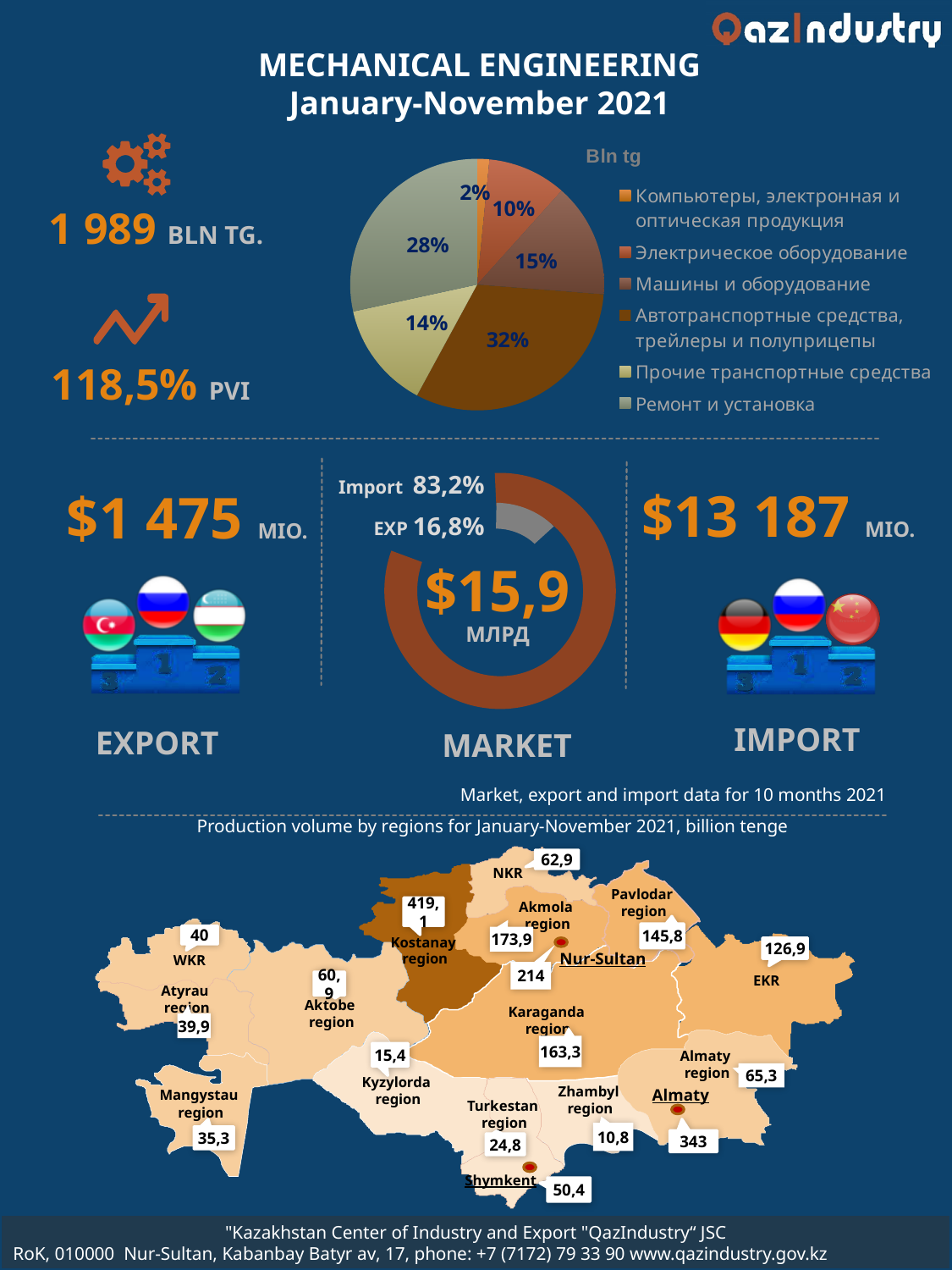
What kind of chart is the 'Bln tg' chart at the top of the slide? pie chart In the 'Bln tg' pie chart, what is the difference between the 32% slice and the 28% slice? 4% How many entries does the legend of the 'Bln tg' pie chart list? 6 In the MARKET donut chart, which is larger, Import or EXP? Import In the 'Bln tg' pie chart, what is the smallest slice's share? 2% In the MARKET donut chart, what share is EXP? 16,8% What value is shown in the centre of the MARKET donut chart? $15,9 млрд In the 'Bln tg' pie chart, what is the largest slice's share? 32% How many slices does the 'Bln tg' pie chart have? 6 On the regional production map, which region has the highest production volume? Kostanay region In the MARKET donut chart, what share is Import? 83,2% In the MARKET donut chart, what is the difference between the Import share and the EXP share? 66,4%